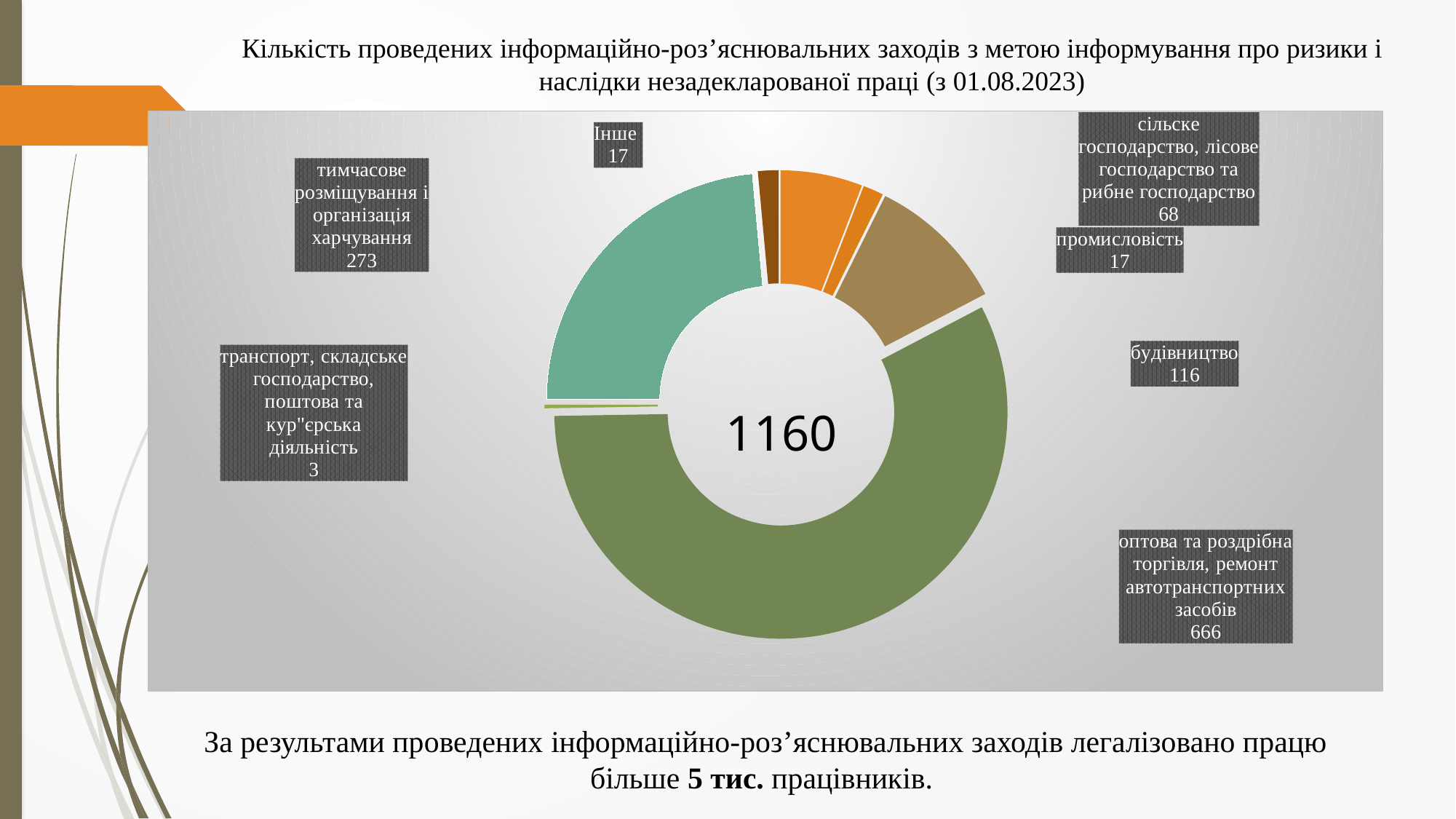
What value is shown for "промисловість"? 17 Which category has the smallest value? транспорт, складське господарство, поштова та кур"єрська діяльність What is the value for "тимчасове розміщування і організація харчування"? 273 Which category has the largest value? оптова та роздрібна торгівля, ремонт автотранспортних засобів Which is larger: the value for "будівництво" or for "сільське господарство, лісове господарство та рибне господарство"? будівництво What type of chart is shown on the slide? Doughnut (pie) chart What total is shown in the centre of the doughnut chart? 1160 What is the difference between the values for "тимчасове розміщування і організація харчування" and "будівництво"? 157 What is the value for "оптова та роздрібна торгівля, ремонт автотранспортних засобів"? 666 What is the value for "будівництво"? 116 How many categories are shown in the chart? 7 What is the value for "сільське господарство, лісове господарство та рибне господарство"? 68